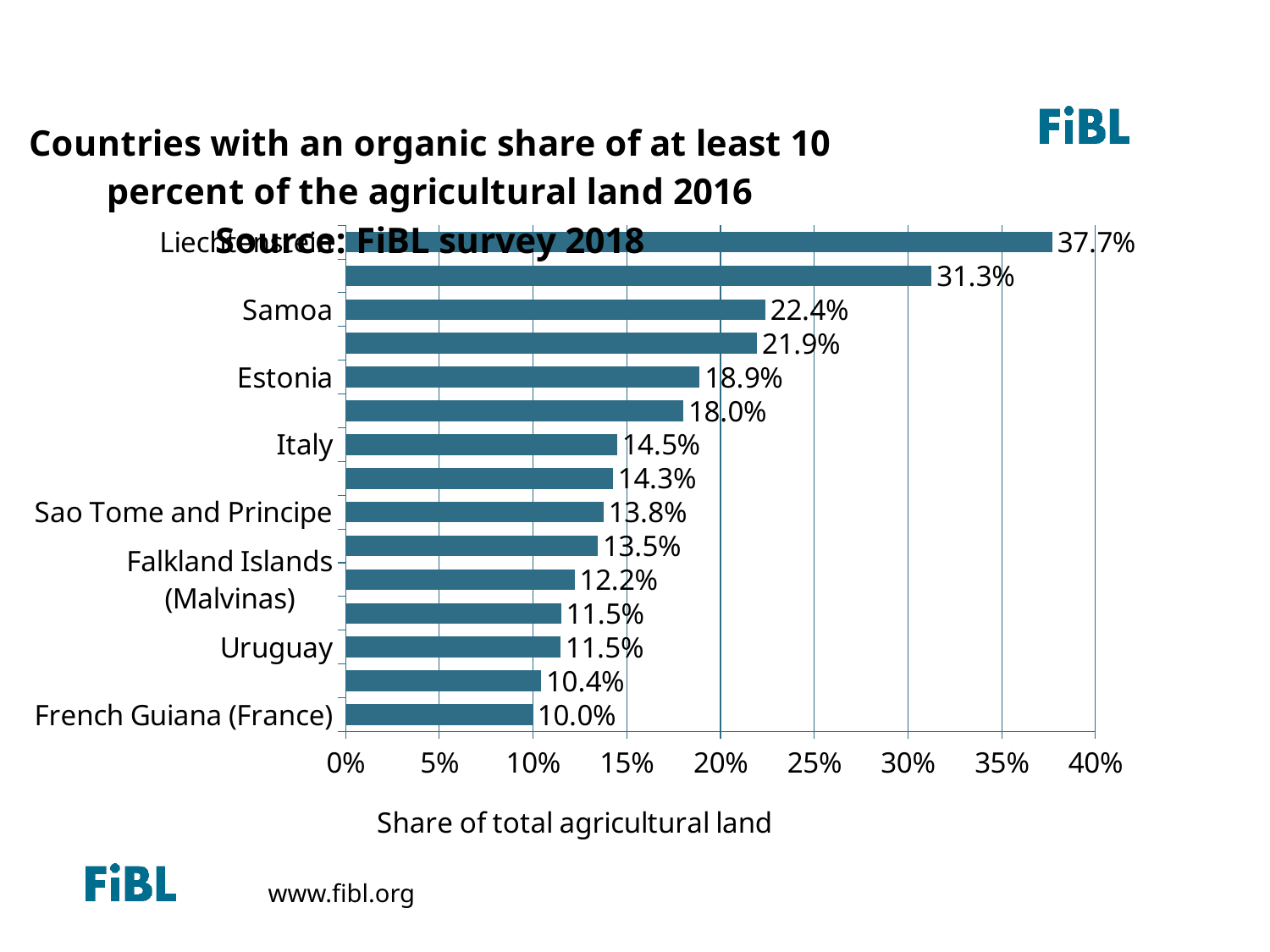
What is the organic share of agricultural land for Sao Tome and Principe? 13.8% Which country has the lowest organic share in the chart? French Guiana (France) What is the organic share of agricultural land for Samoa? 22.4% Which has a larger organic share, Italy or Uruguay? Italy What is the organic share of agricultural land for French Guiana (France)? 10.0% What is the organic share of agricultural land for Italy? 14.5% What kind of chart is shown on the slide? bar chart Is the value for Falkland Islands (Malvinas) greater or less than 15%? less How many bars are plotted in the chart? 15 What is the difference between the organic shares of Samoa and Estonia? 3.5 percentage points What is the highest value shown in the chart? 37.7% What is the organic share of agricultural land for Estonia? 18.9%